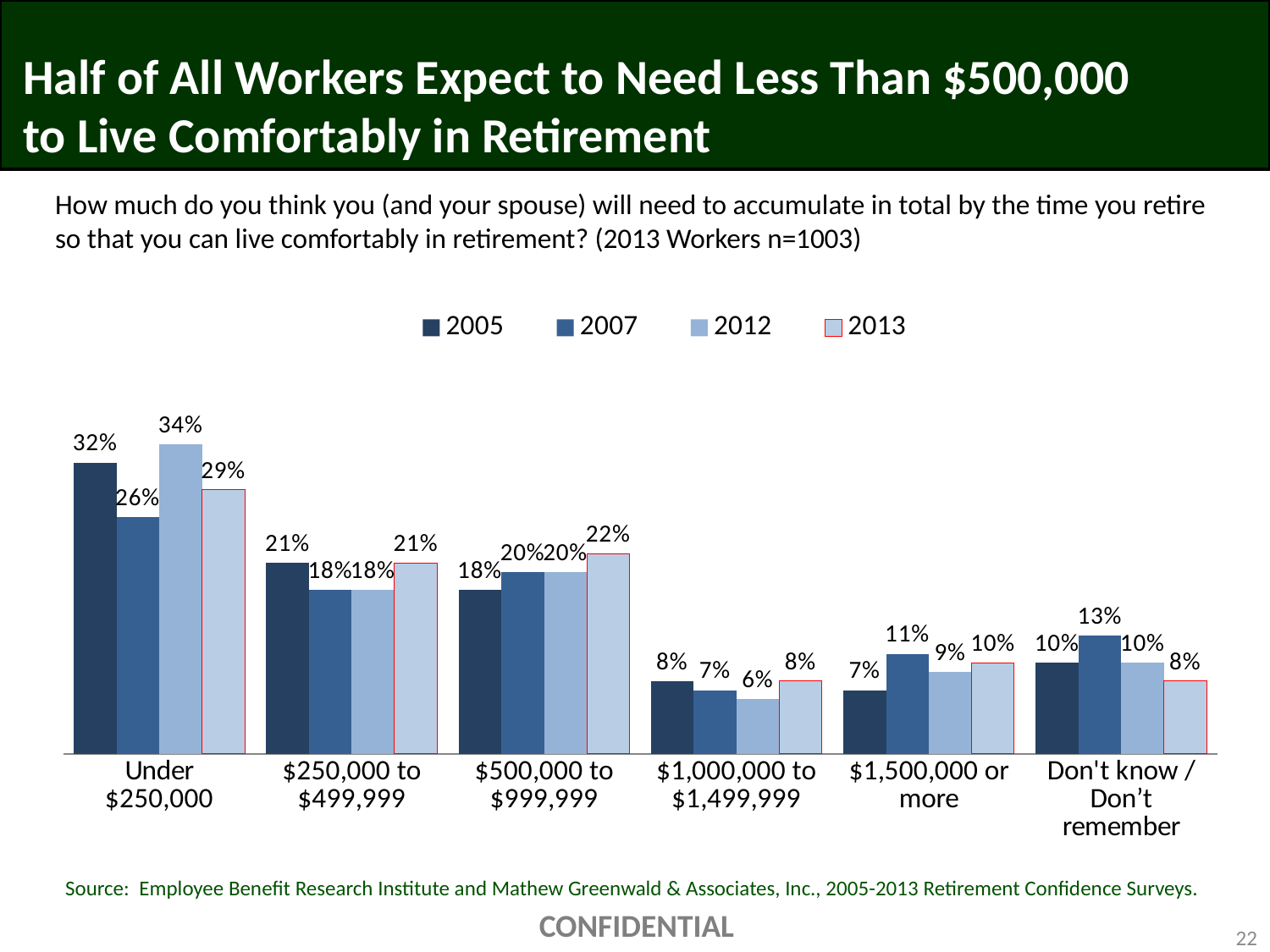
Do the 2013 values rise or fall from Under $250,000 to $1,000,000 to $1,499,999? Fall Which series is drawn with a red outline? 2013 What is the difference between the 2012 and 2013 values for Under $250,000? 5% Which category has the highest 2012 value? Under $250,000 Which category has the lowest 2005 value? $1,500,000 or more How many categories are shown on the x axis? 6 What is the 2007 value for Don't know / Don't remember? 13% What is the 2013 value for Under $250,000? 29% Which is larger for $500,000 to $999,999: the 2005 value or the 2013 value? 2013 What is the 2012 value for $1,000,000 to $1,499,999? 6% What kind of chart is shown on the slide? Bar chart How many series does the legend list? 4